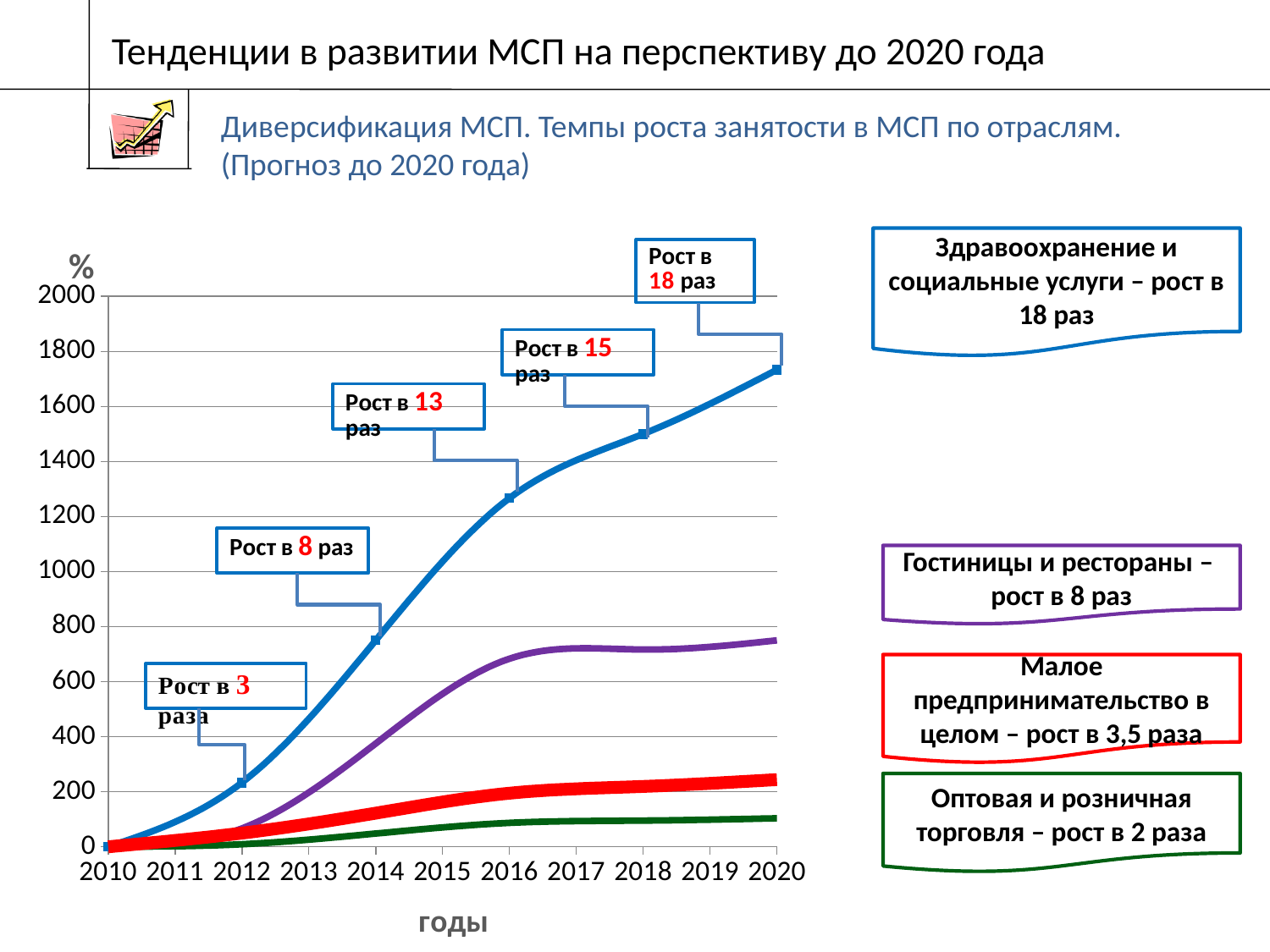
Does the blue line (Здравоохранение и социальные услуги) rise or fall from 2010 to 2020? rises Which line has the lowest value in 2020? Оптовая и розничная торговля (green) Is the value of the green line (Оптовая и розничная торговля) in 2020 greater or less than 200? less Is the value of the purple line (Гостиницы и рестораны) in 2020 greater or less than 600? greater How many lines (series) are plotted on the chart? 4 In 2020, which is higher: the blue line (Здравоохранение и социальные услуги) or the purple line (Гостиницы и рестораны)? blue line (Здравоохранение и социальные услуги) What kind of chart is shown on the slide? line chart Which line has the highest value in 2020? Здравоохранение и социальные услуги (blue) Is the value of the blue line (Здравоохранение и социальные услуги) in 2020 greater or less than 1600? greater What growth multiple does the callout on the blue line show for 2014? Рост в 8 раз How many years are marked along the x axis of the chart? 11